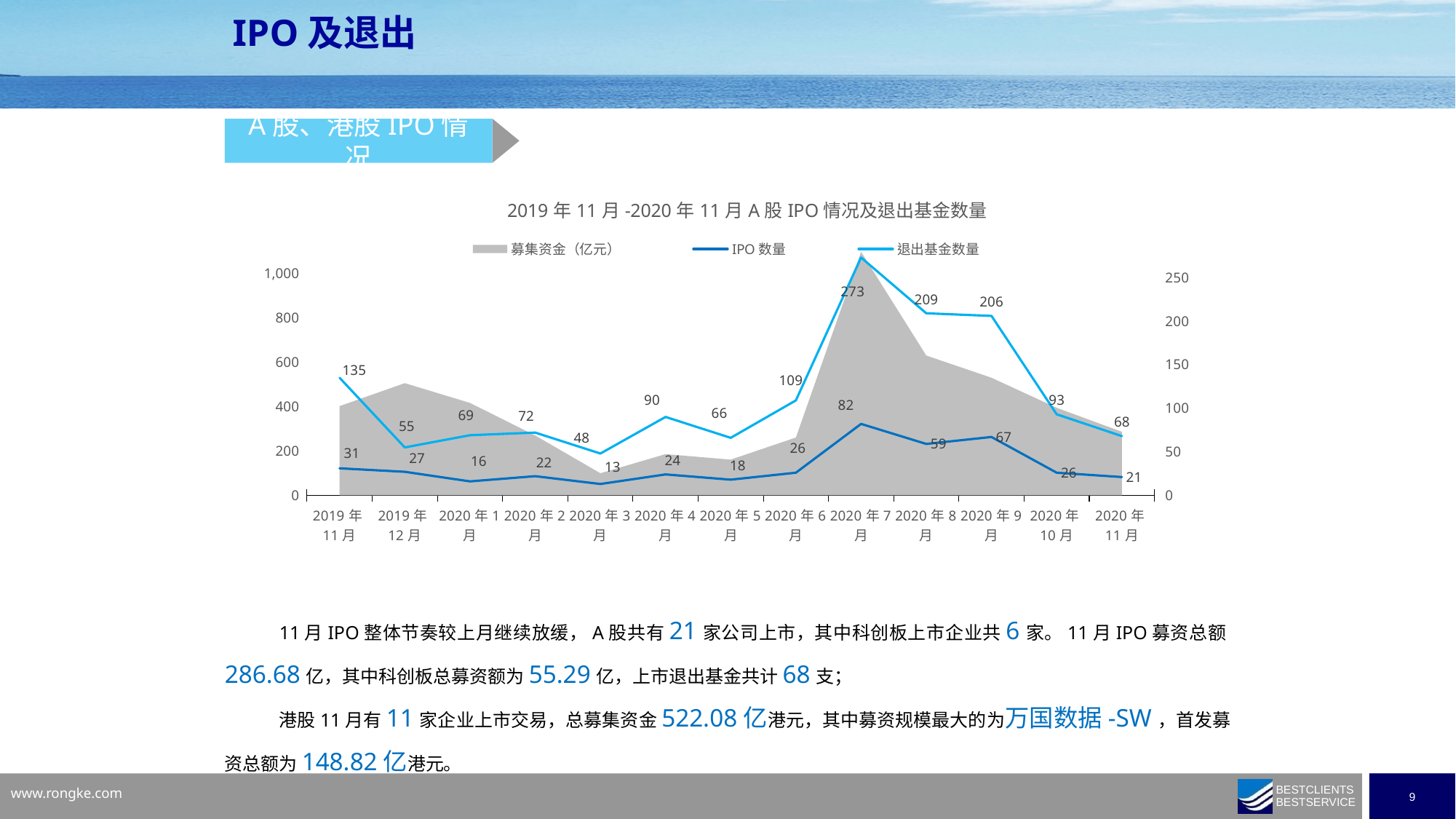
What is the difference between the 退出基金数量 for 2020 年 8 月 and 2020 年 9 月? 3 How many series does the chart legend list? 3 Which month has the lowest IPO 数量? 2020 年 3 月 Is the 募集资金（亿元）value for 2020 年 7 月 greater or less than 800? greater How many months are shown on the x axis of the chart? 13 Does the IPO 数量 rise or fall from 2020 年 7 月 to 2020 年 11 月? fall What is the IPO 数量 value for 2020 年 7 月? 82 Which month has the highest 退出基金数量? 2020 年 7 月 What is the title of the chart? 2019 年 11 月 -2020 年 11 月 A 股 IPO 情况及退出基金数量 What is the 退出基金数量 value for 2019 年 11 月? 135 What is the 退出基金数量 value for 2020 年 11 月? 68 Which is larger, the IPO 数量 for 2020 年 8 月 or for 2020 年 9 月? 2020 年 9 月